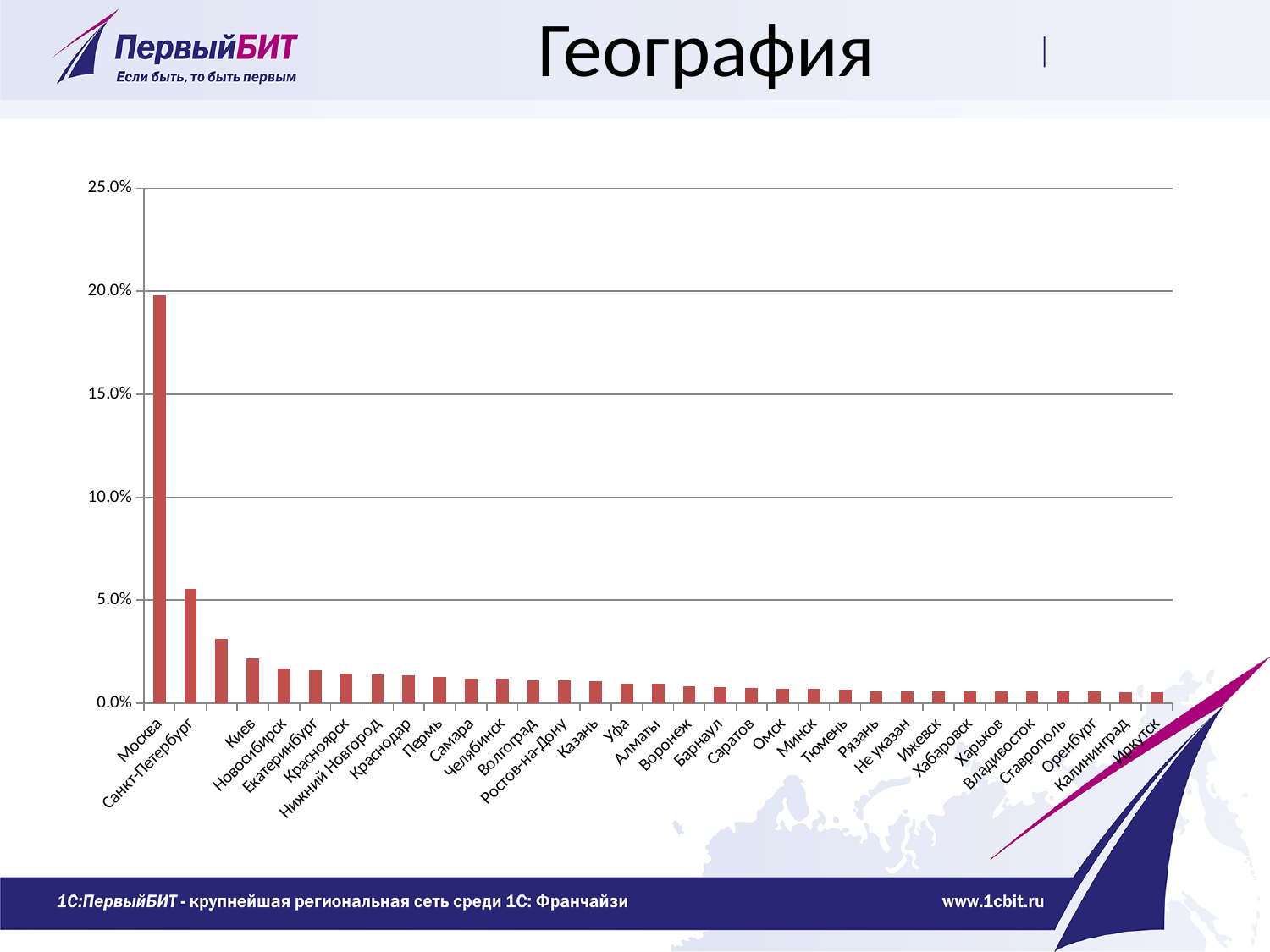
What kind of chart is shown on the slide? bar chart What is the title of the slide containing the chart? География Is the value for Киев greater or less than 5.0%? less Do the values rise or fall moving from left to right along the x axis? fall Which has a larger value, Санкт-Петербург or Казань? Санкт-Петербург Is the value for Санкт-Петербург greater or less than 10.0%? less Which city has the highest value in the chart? Москва Which has a larger value, Москва or Санкт-Петербург? Москва Is the value for Москва greater or less than 15.0%? greater Which has a larger value, Киев or Новосибирск? Киев What is the highest value shown on the vertical axis? 25.0%